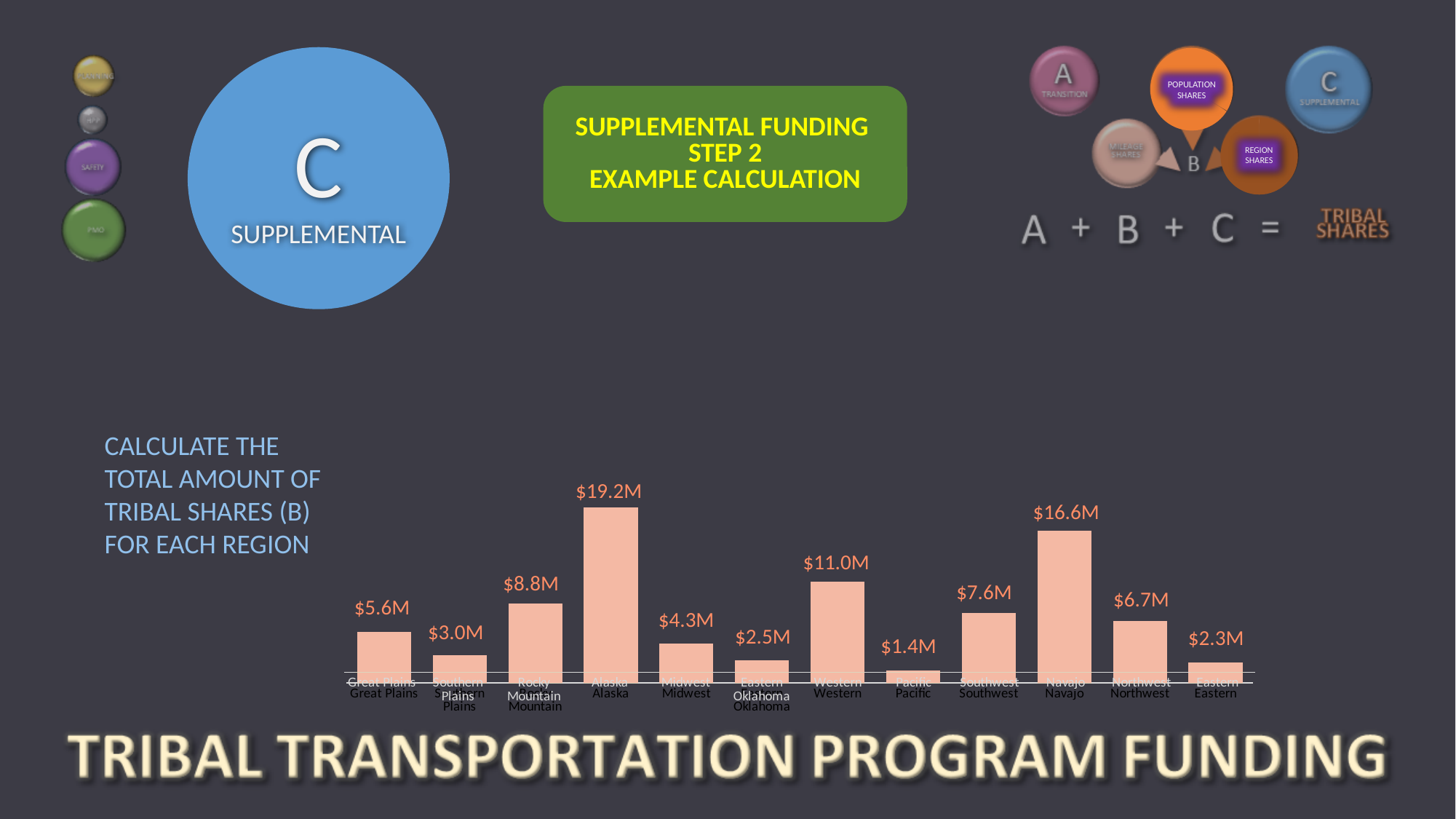
What is the value shown for Navajo? $16.6M What is the difference between the values for Western and Southwest? $3.4M What is the value shown for Southern Plains? $3.0M What is the value shown for Pacific? $1.4M What is the value shown for Alaska? $19.2M Which is larger, the value for Rocky Mountain or the value for Northwest? Rocky Mountain What is the value shown for Eastern Oklahoma? $2.5M Which region has the highest value? Alaska What is the difference between the values for Alaska and Navajo? $2.6M What kind of chart is shown on the slide? Bar chart How many regions are shown in the chart? 12 Which region has the lowest value? Pacific